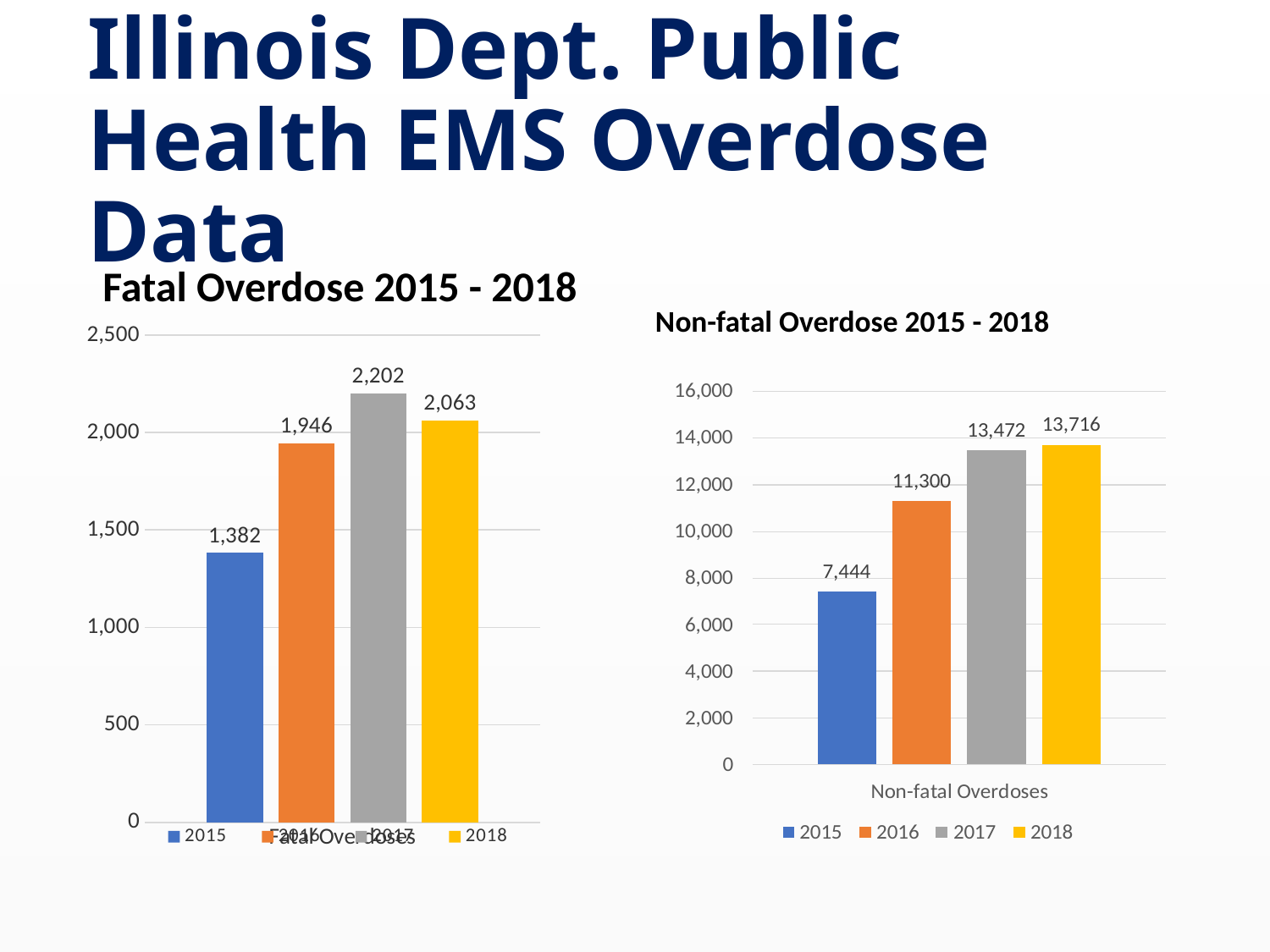
In the 'Fatal Overdose 2015 - 2018' chart, what is the value for 2017? 2,202 In the 'Fatal Overdose 2015 - 2018' chart, which year has the highest value? 2017 In the 'Non-fatal Overdose 2015 - 2018' chart, is the value for 2016 greater or less than 12,000? less How many series does the legend of the 'Non-fatal Overdose 2015 - 2018' chart list? 4 In the 'Fatal Overdose 2015 - 2018' chart, what is the difference between the 2016 and 2015 values? 564 In the 'Non-fatal Overdose 2015 - 2018' chart, what is the value for 2016? 11,300 In the 'Non-fatal Overdose 2015 - 2018' chart, what is the difference between the 2018 and 2017 values? 244 In the 'Fatal Overdose 2015 - 2018' chart, which is larger, the value for 2017 or the value for 2018? 2017 In the 'Non-fatal Overdose 2015 - 2018' chart, what is the value for 2018? 13,716 What kind of chart is the 'Fatal Overdose 2015 - 2018' chart? bar chart In the 'Non-fatal Overdose 2015 - 2018' chart, which year has the lowest value? 2015 In the 'Fatal Overdose 2015 - 2018' chart, what is the value for 2015? 1,382